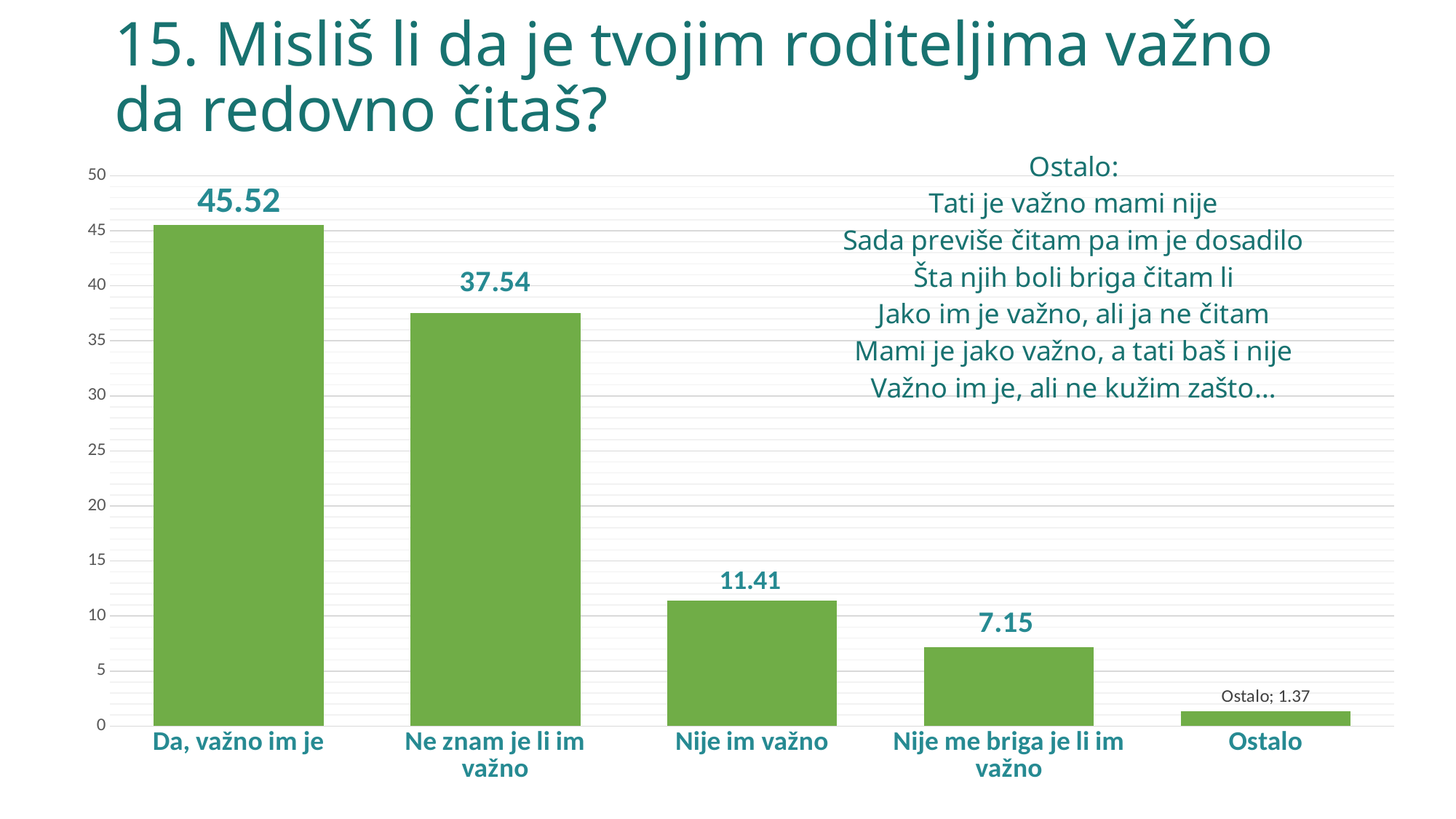
What is the value for "Ostalo"? 1.37 What is the value for "Ne znam je li im važno"? 37.54 What is the value for "Da, važno im je"? 45.52 What kind of chart is shown on the slide? Bar chart How many categories are shown in the chart? 5 Which category has the lowest value? Ostalo What is the value for "Nije im važno"? 11.41 What is the value for "Nije me briga je li im važno"? 7.15 Which is larger, the value for "Nije im važno" or the value for "Nije me briga je li im važno"? Nije im važno What is the difference between the values for "Da, važno im je" and "Ne znam je li im važno"? 7.98 Do the values rise or fall from left to right along the x axis? Fall Which category has the highest value? Da, važno im je